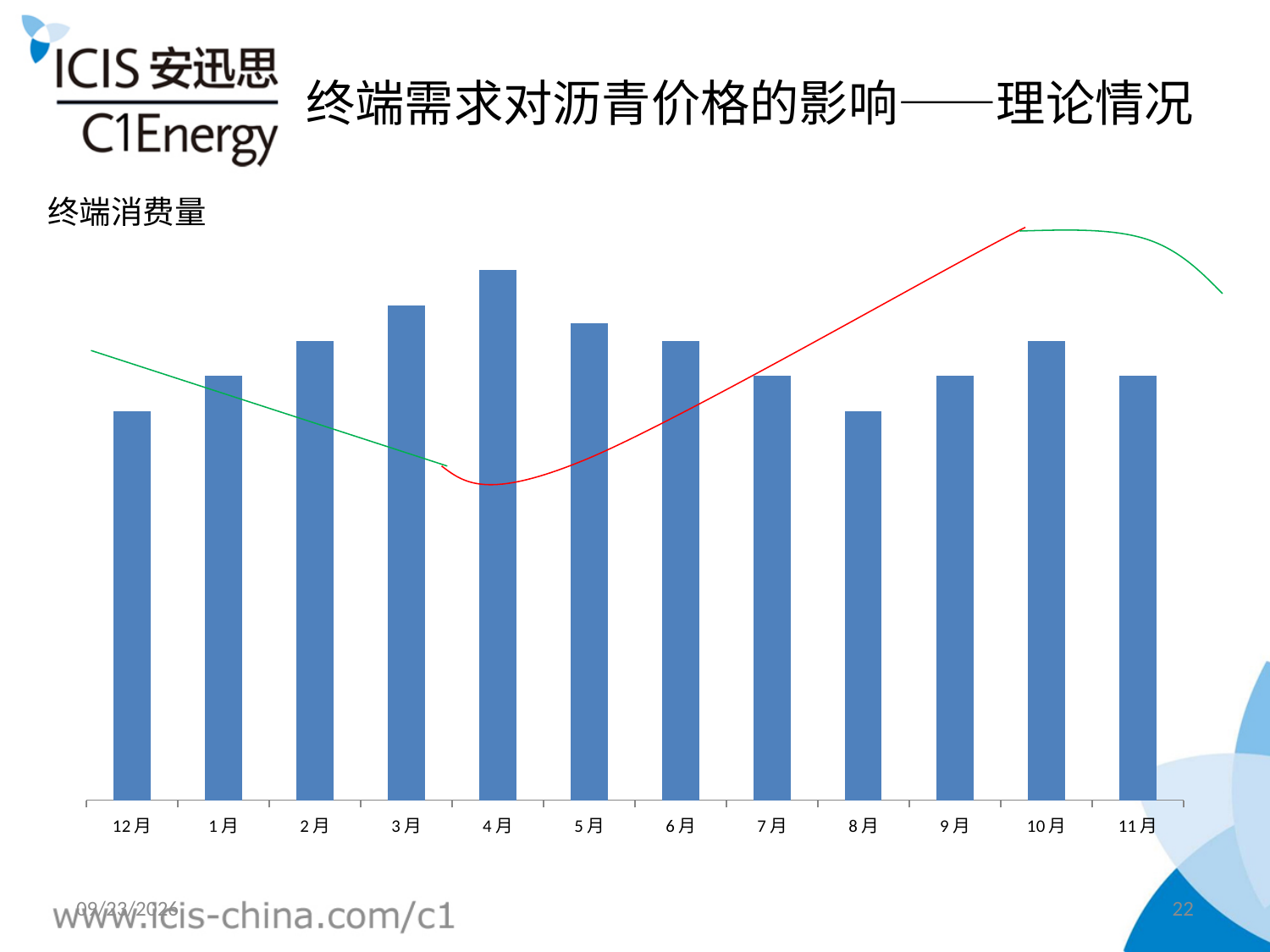
Which is larger, the bar for 8月 or the bar for 10月? 10月 Do the bars rise or fall from 4月 to 8月? fall Which is larger, the bar for 1月 or the bar for 2月? 2月 What kind of chart is shown on the slide? bar chart Do the bars rise or fall from 12月 to 4月? rise What is the title shown above the chart? 终端消费量 Which is larger, the bar for 5月 or the bar for 7月? 5月 How many months are shown on the x axis of the chart? 12 Which month has the highest bar in the chart? 4月 Which month is the first category on the x axis? 12月